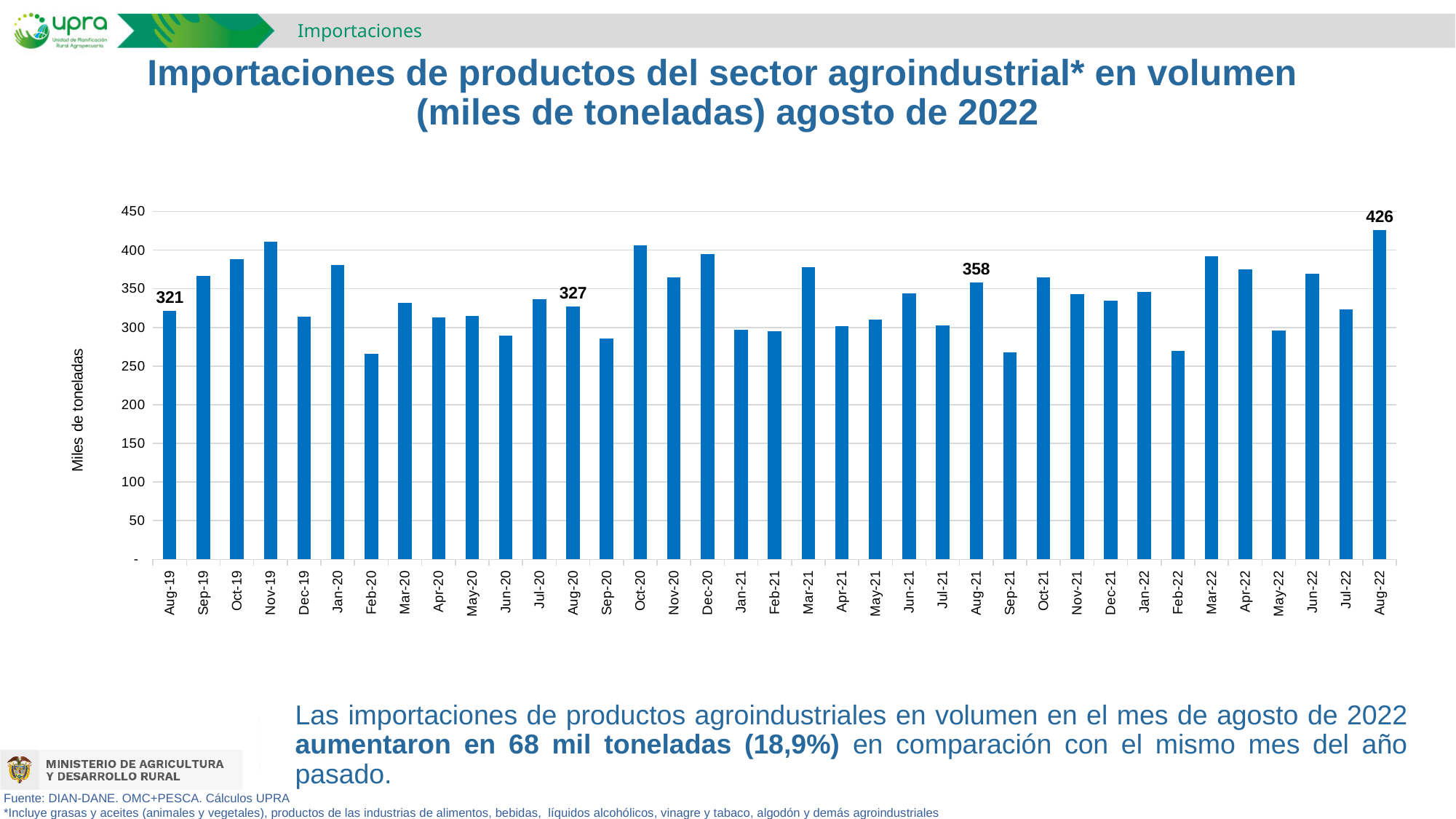
Which month has the highest value? Aug-22 What is the label of the vertical axis? Miles de toneladas What is the difference between the values for Aug-22 and Aug-21? 68 What is the difference between the values for Aug-21 and Aug-20? 31 Is the value for Nov-19 greater or less than 400? greater What is the value for Aug-21? 358 What is the value for Aug-20? 327 What is the value for Aug-22? 426 What is the value for Aug-19? 321 What kind of chart is shown on the slide? bar chart Is the value for Feb-20 greater or less than 300? less Which is larger, the value for Aug-21 or the value for Aug-20? Aug-21